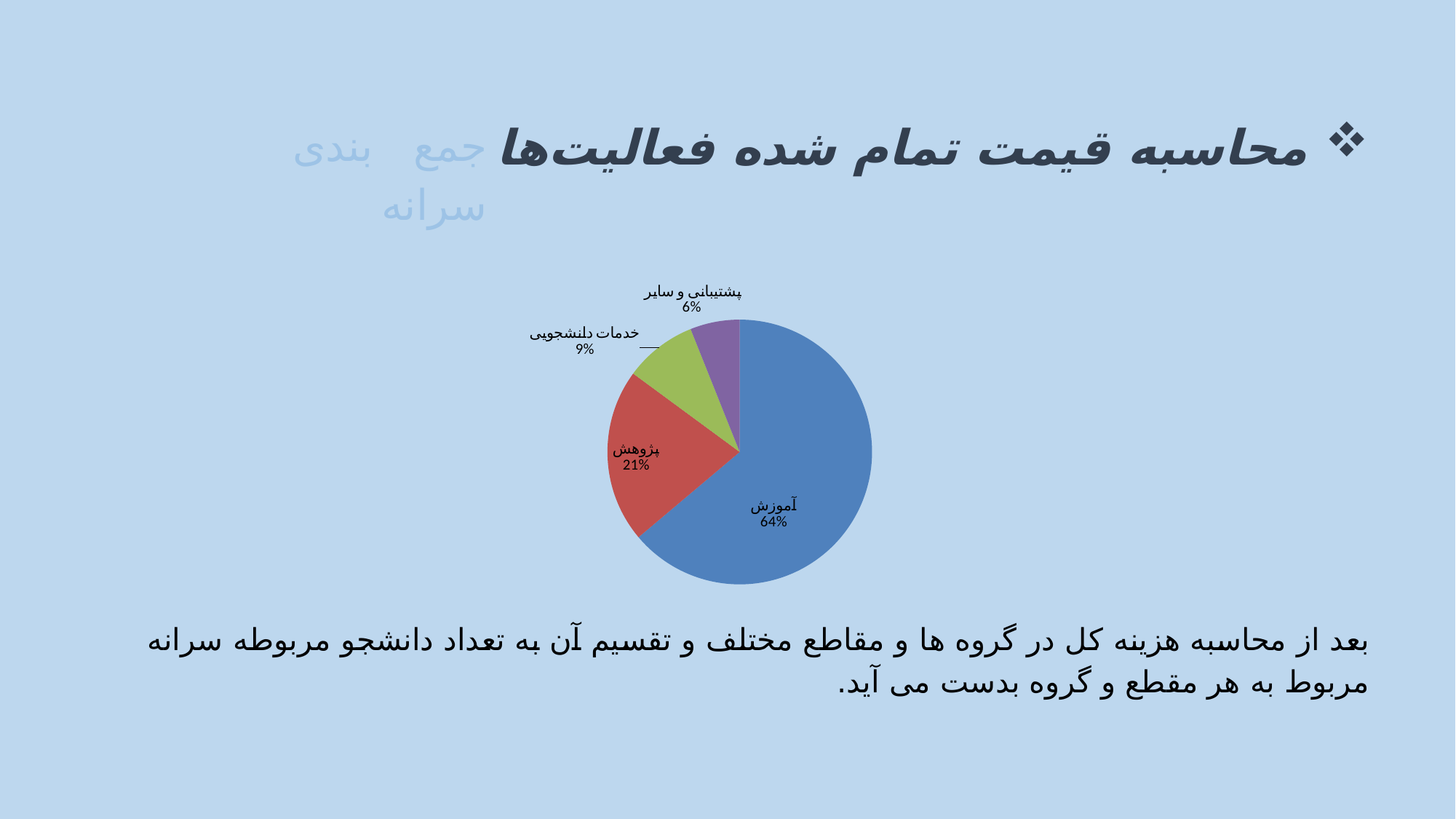
What kind of chart is shown on the slide? pie chart Which category has the smallest slice of the pie? پشتیبانی و سایر What share of the pie does خدمات دانشجویی have? 9% What share of the pie does آموزش have? 64% Which is larger, the slice for خدمات دانشجویی or the slice for پشتیبانی و سایر? خدمات دانشجویی What is the combined share of پژوهش and خدمات دانشجویی? 30% What share of the pie does پشتیبانی و سایر have? 6% What is the difference in percentage points between آموزش and پژوهش? 43 How many slices does the pie chart have? 4 Which category has the largest slice of the pie? آموزش What share of the pie does پژوهش have? 21% What colour is the slice for آموزش? blue